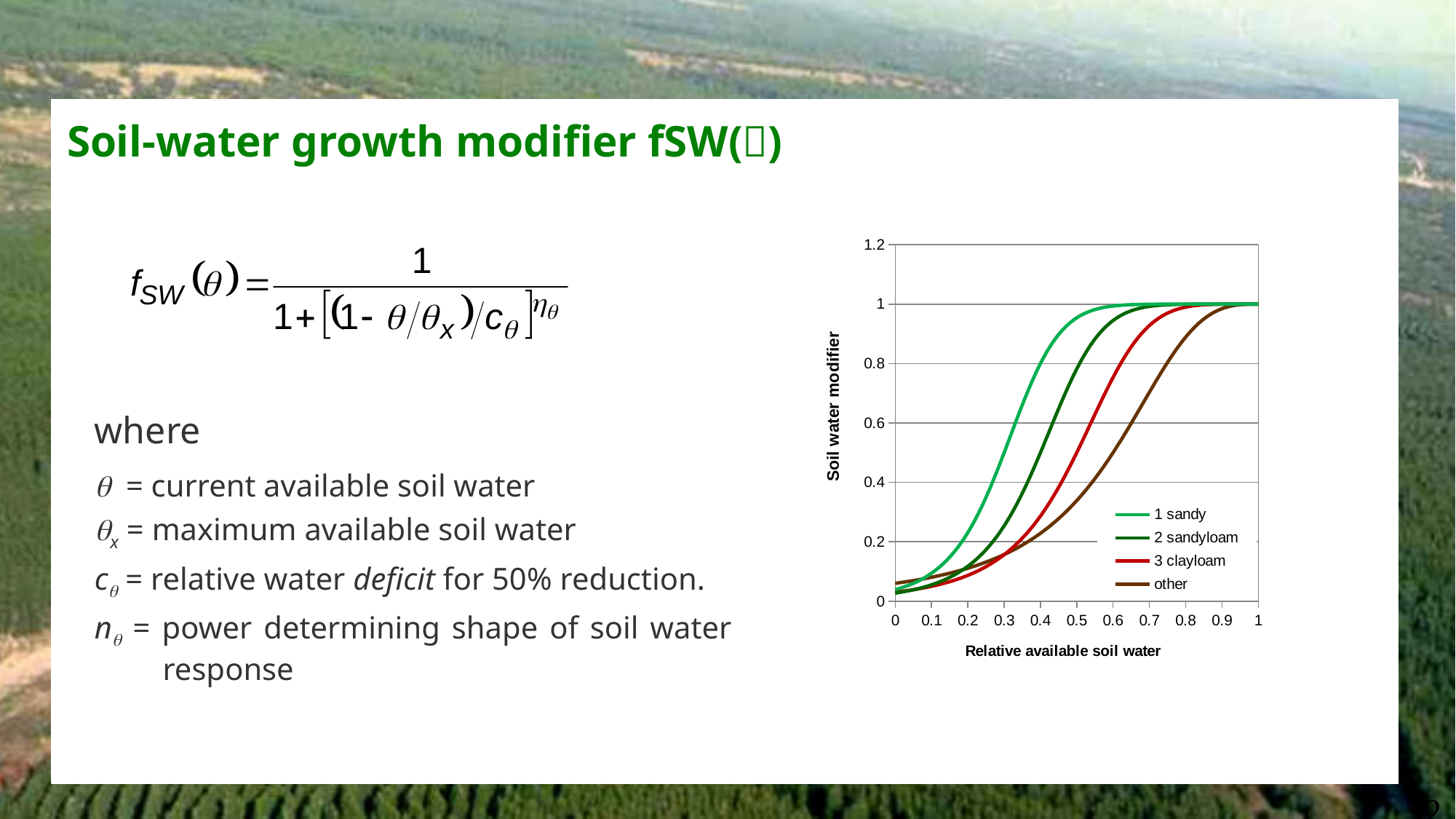
What kind of chart is shown on the slide? line chart At a relative available soil water of 0.5, which series has the lowest soil water modifier? other At a relative available soil water of 0.7, is the value for the '3 clayloam' series greater or less than 0.8? greater At a relative available soil water of 0.3, which series has the highest soil water modifier? 1 sandy At a relative available soil water of 0.4, is the value for the '3 clayloam' series greater or less than 0.4? less At a relative available soil water of 0.4, which series has the higher soil water modifier, '1 sandy' or 'other'? 1 sandy At a relative available soil water of 0.5, is the value for the 'other' series greater or less than 0.4? less Do the curves rise or fall as relative available soil water increases from 0 to 1? rise What is the title of the chart's x axis? Relative available soil water How many series does the chart legend list? 4 What is the title of the chart's y axis? Soil water modifier